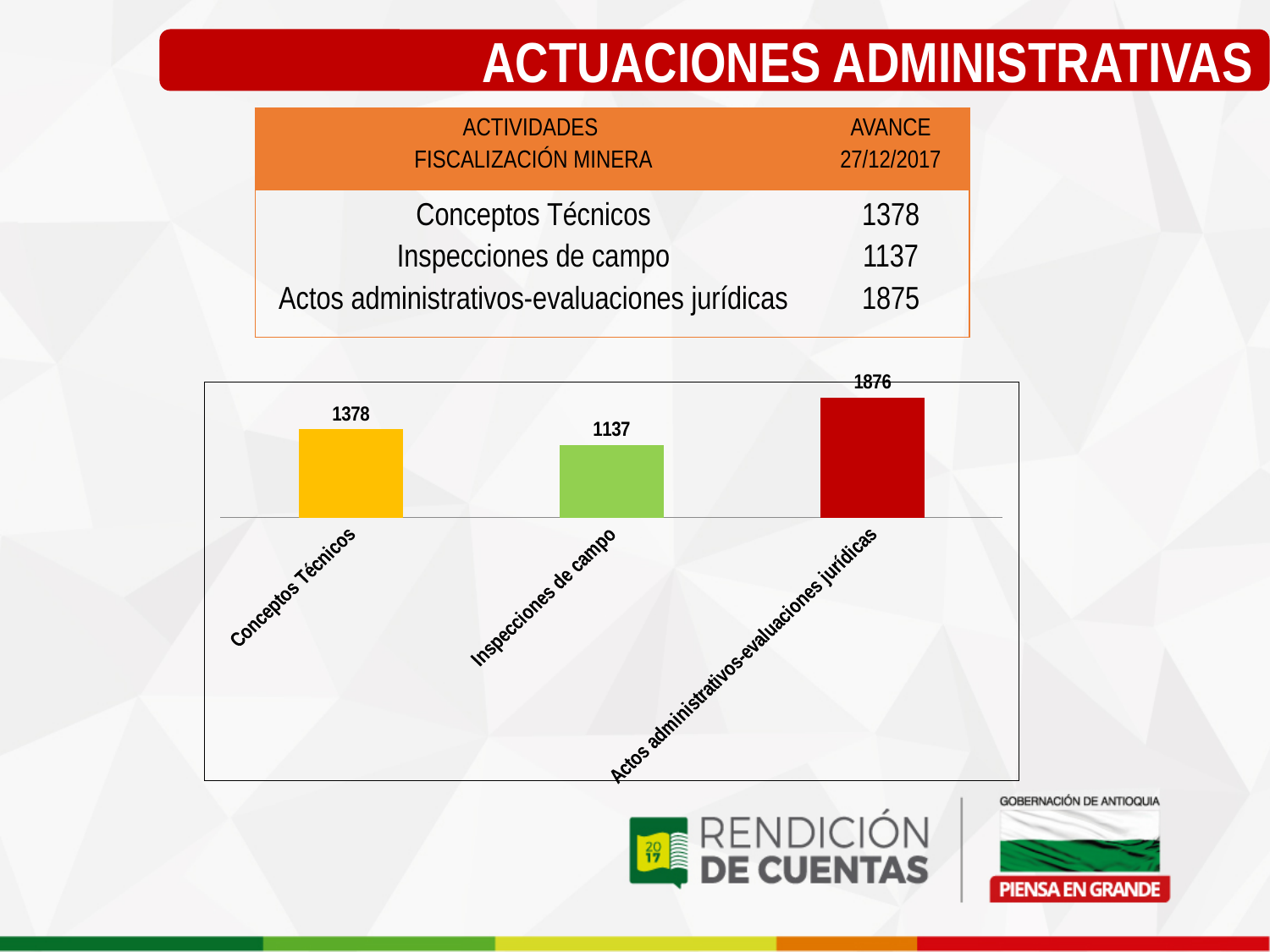
What is the value shown for Actos administrativos-evaluaciones jurídicas in the chart? 1876 Which is larger in the chart, Conceptos Técnicos or Inspecciones de campo? Conceptos Técnicos What is the value shown for Inspecciones de campo in the chart? 1137 What colour is the bar for Actos administrativos-evaluaciones jurídicas? Red Which category has the lowest value in the chart? Inspecciones de campo What kind of chart is shown on the slide? Bar chart How many categories are shown in the chart? 3 What is the difference between the values for Conceptos Técnicos and Inspecciones de campo in the chart? 241 What is the difference between the values for Actos administrativos-evaluaciones jurídicas and Conceptos Técnicos in the chart? 498 What colour is the bar for Inspecciones de campo? Green Which category has the highest value in the chart? Actos administrativos-evaluaciones jurídicas What is the value shown for Conceptos Técnicos in the chart? 1378